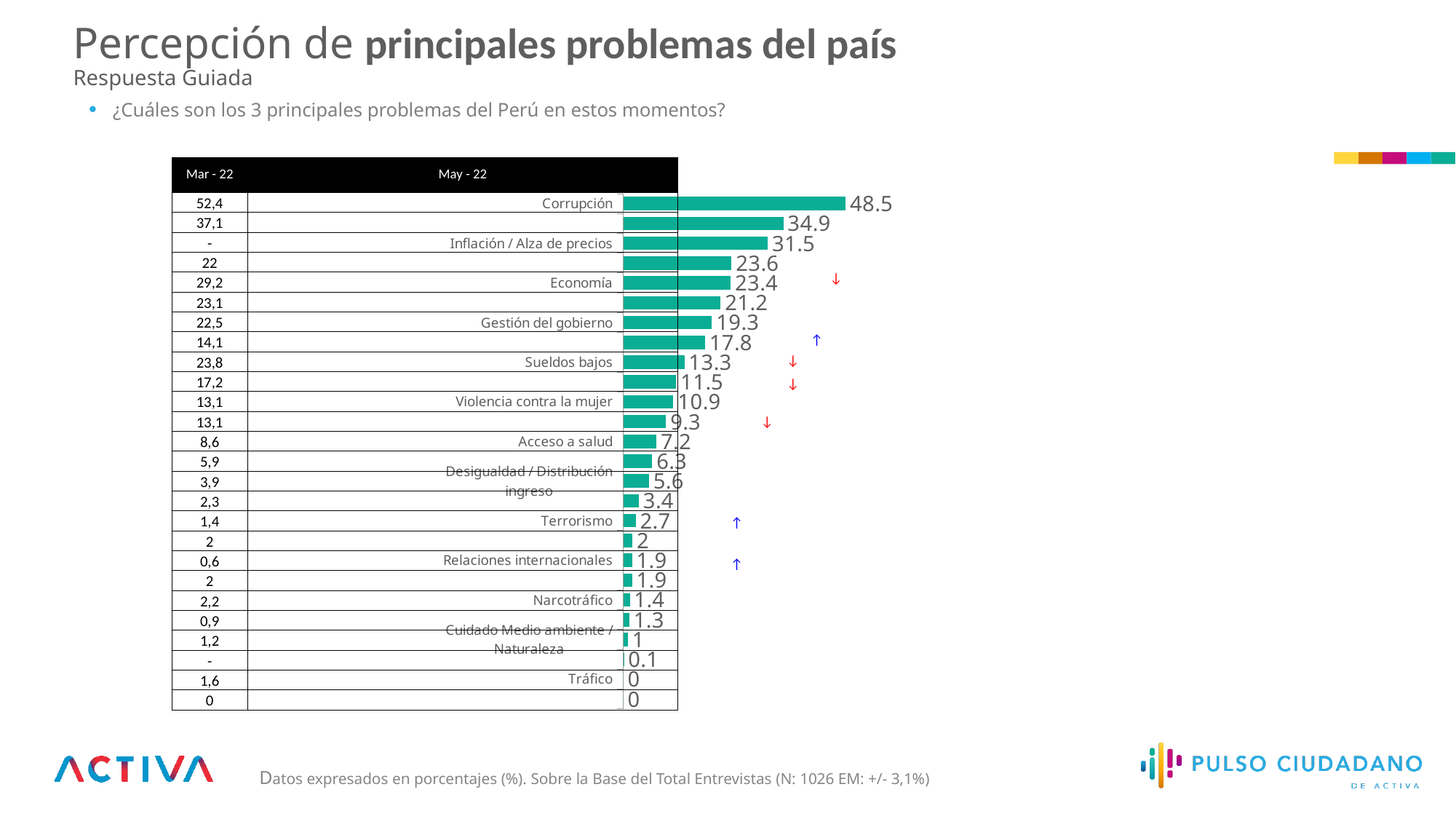
What is the difference between the values for Corrupción and Inflación / Alza de precios? 17 What is the value for Terrorismo? 2.7 Which category has the highest value? Corrupción What is the value for Violencia contra la mujer? 10.9 What is the value for Gestión del gobierno? 19.3 What is the value for Corrupción? 48.5 What is the value for Sueldos bajos? 13.3 Which is larger, the value for Economía or the value for Gestión del gobierno? Economía What is the value for Economía? 23.4 What is the value for Inflación / Alza de precios? 31.5 How many bars are plotted in the chart? 26 What kind of chart is shown on the slide? Bar chart